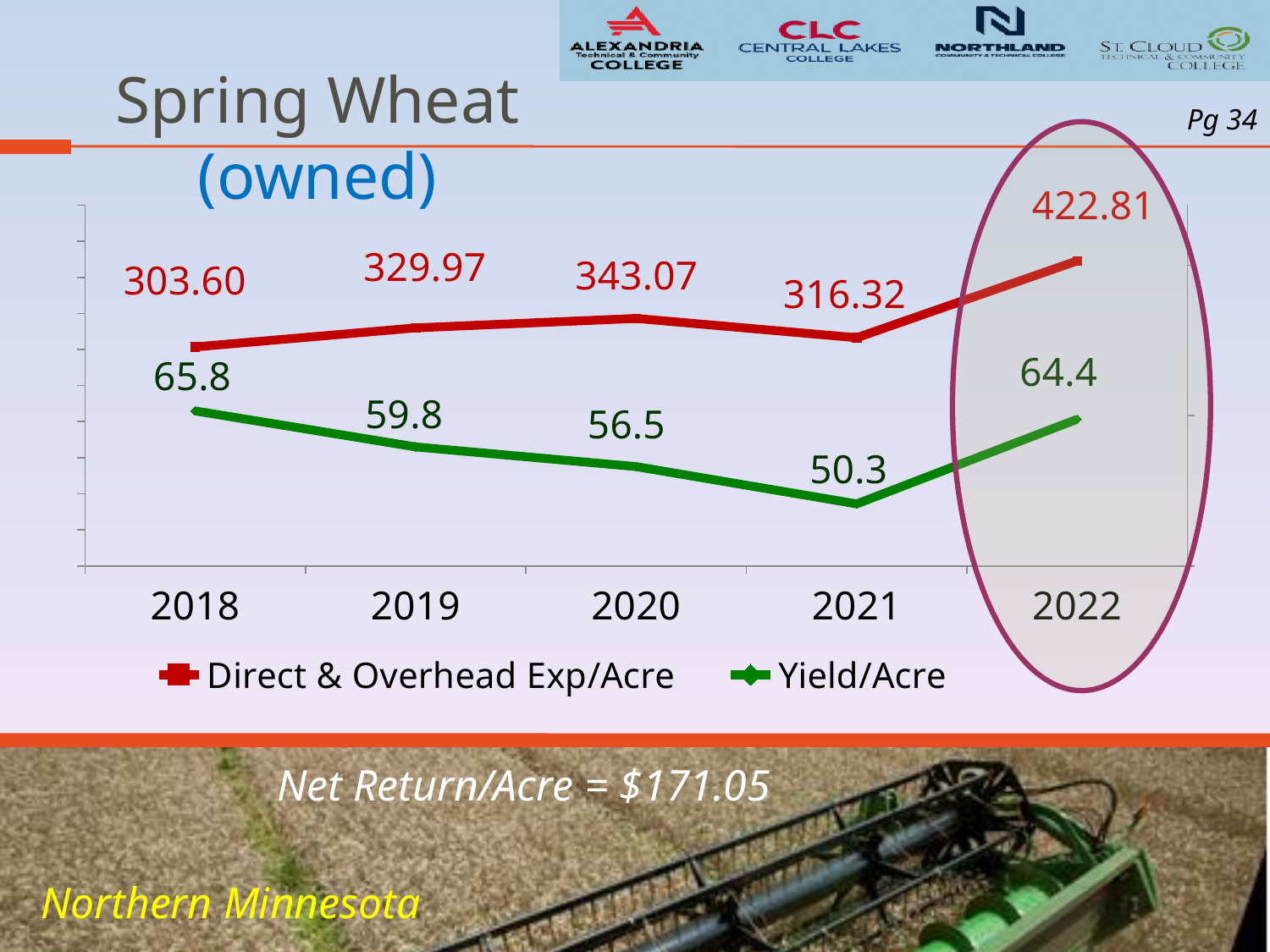
What kind of chart is shown on the slide? Line chart What is the Yield/Acre value for 2021? 50.3 Which year has the lowest Direct & Overhead Exp/Acre? 2018 Which year has the highest Yield/Acre? 2018 What is the Direct & Overhead Exp/Acre value for 2018? 303.60 What is the Direct & Overhead Exp/Acre value for 2022? 422.81 How many series does the legend list? 2 What is the difference in Yield/Acre between 2018 and 2021? 15.5 Which year has the lowest Yield/Acre? 2021 How many years are shown on the x axis? 5 What is the difference in Direct & Overhead Exp/Acre between 2022 and 2021? 106.49 Which is larger, the Direct & Overhead Exp/Acre in 2019 or in 2020? 2020